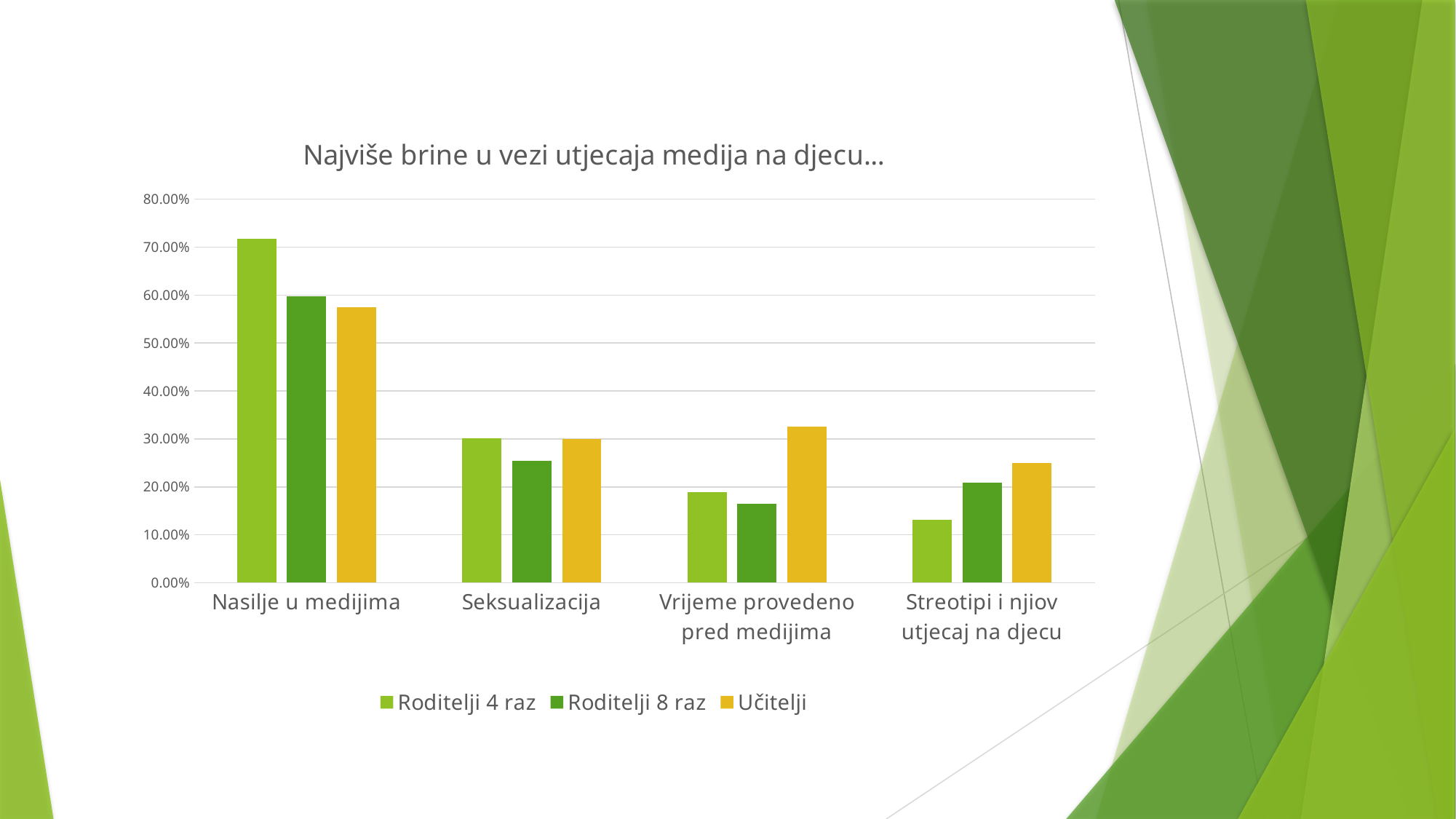
Do the values for Roditelji 4 raz rise or fall from Nasilje u medijima to Streotipi i njiov utjecaj na djecu? fall Is the value for Roditelji 4 raz in Nasilje u medijima greater or less than 60.00%? greater In the Streotipi i njiov utjecaj na djecu category, which is larger: Roditelji 4 raz or Učitelji? Učitelji How many categories are shown on the x axis? 4 Which series has the highest value in the Vrijeme provedeno pred medijima category? Učitelji What is the title of the chart? Najviše brine u vezi utjecaja medija na djecu… Which category has the lowest value for Roditelji 4 raz? Streotipi i njiov utjecaj na djecu Which category has the highest value for Roditelji 4 raz? Nasilje u medijima What type of chart is shown on the slide? bar chart Is the value for Učitelji in Vrijeme provedeno pred medijima greater or less than 30.00%? greater Is the value for Roditelji 8 raz in Vrijeme provedeno pred medijima greater or less than 20.00%? less How many series does the legend list? 3